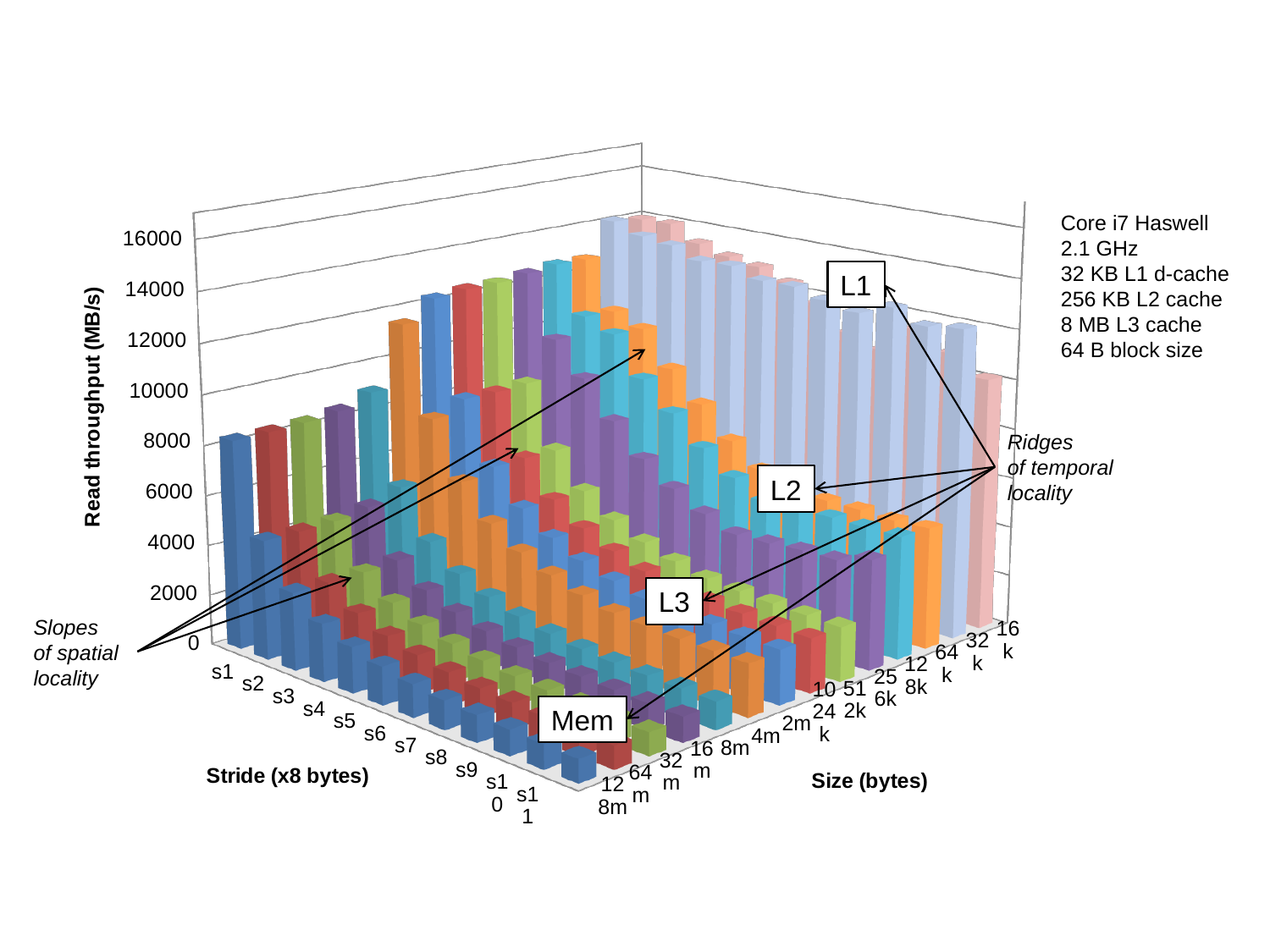
What is the highest tick value shown on the vertical axis? 16000 Which has the higher read throughput at size 128m: stride s1 or stride s11? stride s1 Which has the higher read throughput: stride s1 at size 16k or stride s1 at size 128m? stride s1 at size 16k What kind of chart is shown on the slide? 3D bar chart How many size categories are shown along the size axis? 14 What is the label of the vertical axis? Read throughput (MB/s) Is the read throughput for stride s1 at size 16k greater or less than 4000? greater For stride s1, do the read throughput values rise or fall as the size decreases from 128m to 16k? rise Is the read throughput for stride s11 at size 128m greater or less than 6000? less How many stride categories are shown along the stride axis? 11 Is the read throughput for stride s11 at size 128m greater or less than 8000? less For size 128m, do the read throughput values rise or fall as the stride increases from s1 to s11? fall